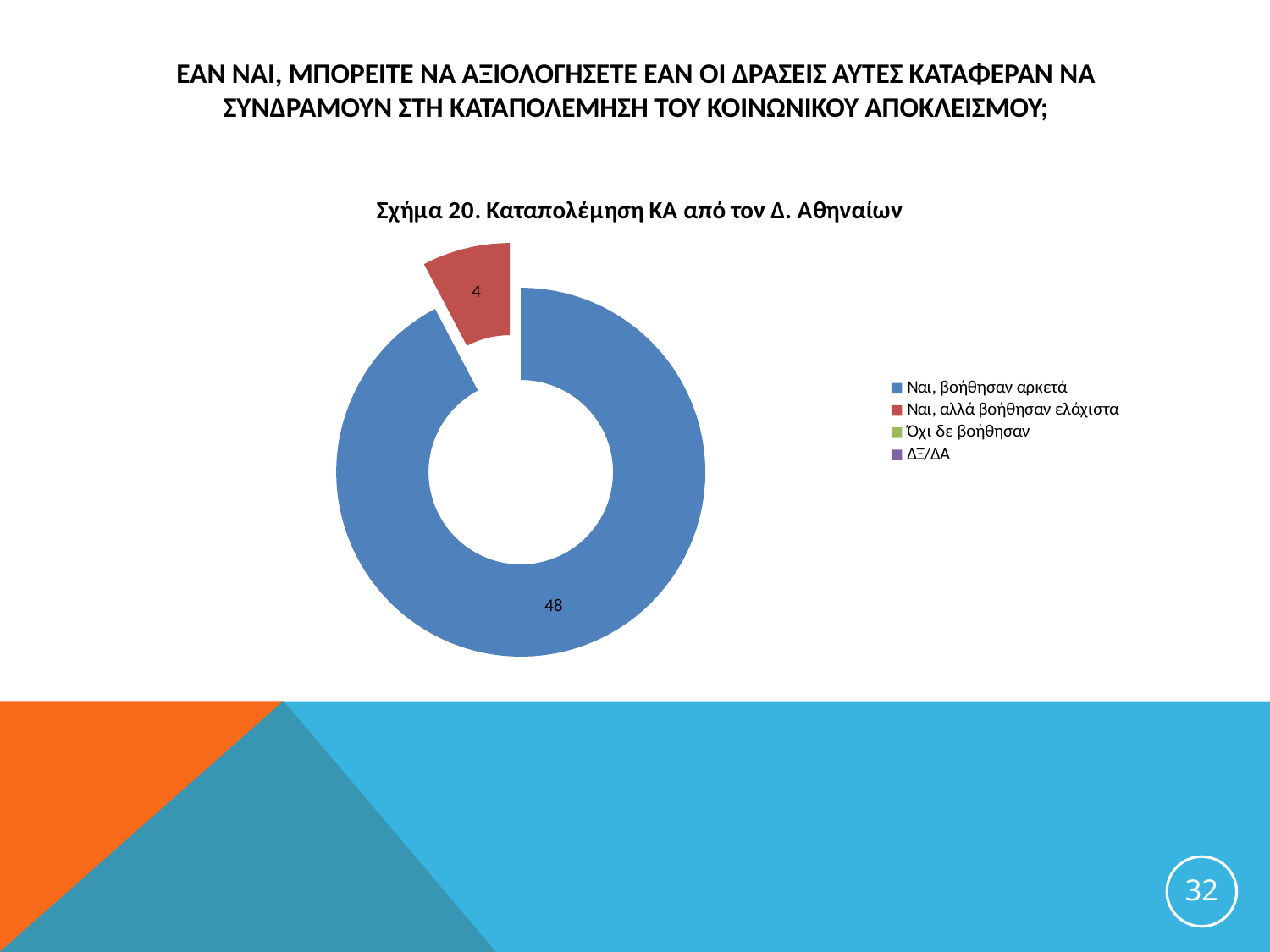
What is the difference between the values for 'Ναι, βοήθησαν αρκετά' and 'Ναι, αλλά βοήθησαν ελάχιστα'? 44 How many categories does the legend list? 4 What kind of chart is shown on the slide? Doughnut (pie) chart What value is shown for the 'Ναι, βοήθησαν αρκετά' slice? 48 Which category has the largest slice in the chart? Ναι, βοήθησαν αρκετά Is the value for 'Ναι, βοήθησαν αρκετά' greater or less than 40? greater What is the title of the chart? Σχήμα 20. Καταπολέμηση ΚΑ από τον Δ. Αθηναίων What colour is the slice for 'Ναι, αλλά βοήθησαν ελάχιστα'? Red Which is larger: the value for 'Ναι, βοήθησαν αρκετά' or the value for 'Ναι, αλλά βοήθησαν ελάχιστα'? Ναι, βοήθησαν αρκετά What value is shown for the 'Ναι, αλλά βοήθησαν ελάχιστα' slice? 4